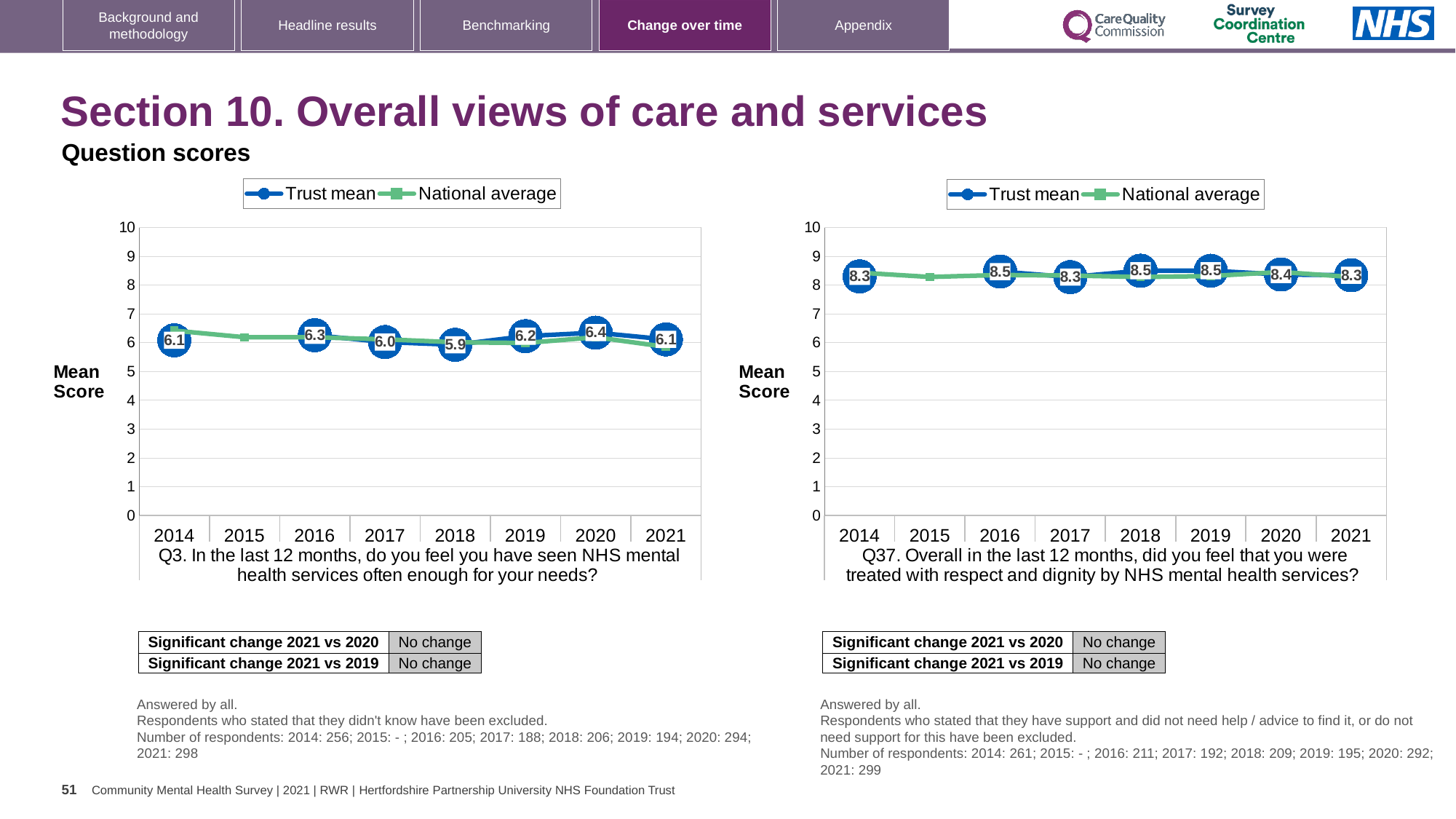
In the Q37 chart on the right, is the Trust mean score for 2019 higher or lower than for 2021? higher How many series does the legend of the Q3 chart on the left list? 2 In the Q3 chart on the left, what is the difference between the Trust mean scores for 2020 and 2018? 0.5 In the Q37 chart on the right, what is the Trust mean score for 2021? 8.3 In the Q3 chart on the left, what is the Trust mean score for 2018? 5.9 How many years are shown on the x axis of the Q37 chart on the right? 8 What type of chart is the Q3 chart on the left? Line chart In the Q3 chart on the left, which year has the highest Trust mean score? 2020 In the Q37 chart on the right, is the Trust mean score for 2014 greater or less than 8? greater In the Q3 chart on the left, which year has the lowest Trust mean score? 2018 In the Q37 chart on the right, what is the Trust mean score for 2016? 8.5 In the Q3 chart on the left, what is the Trust mean score for 2020? 6.4